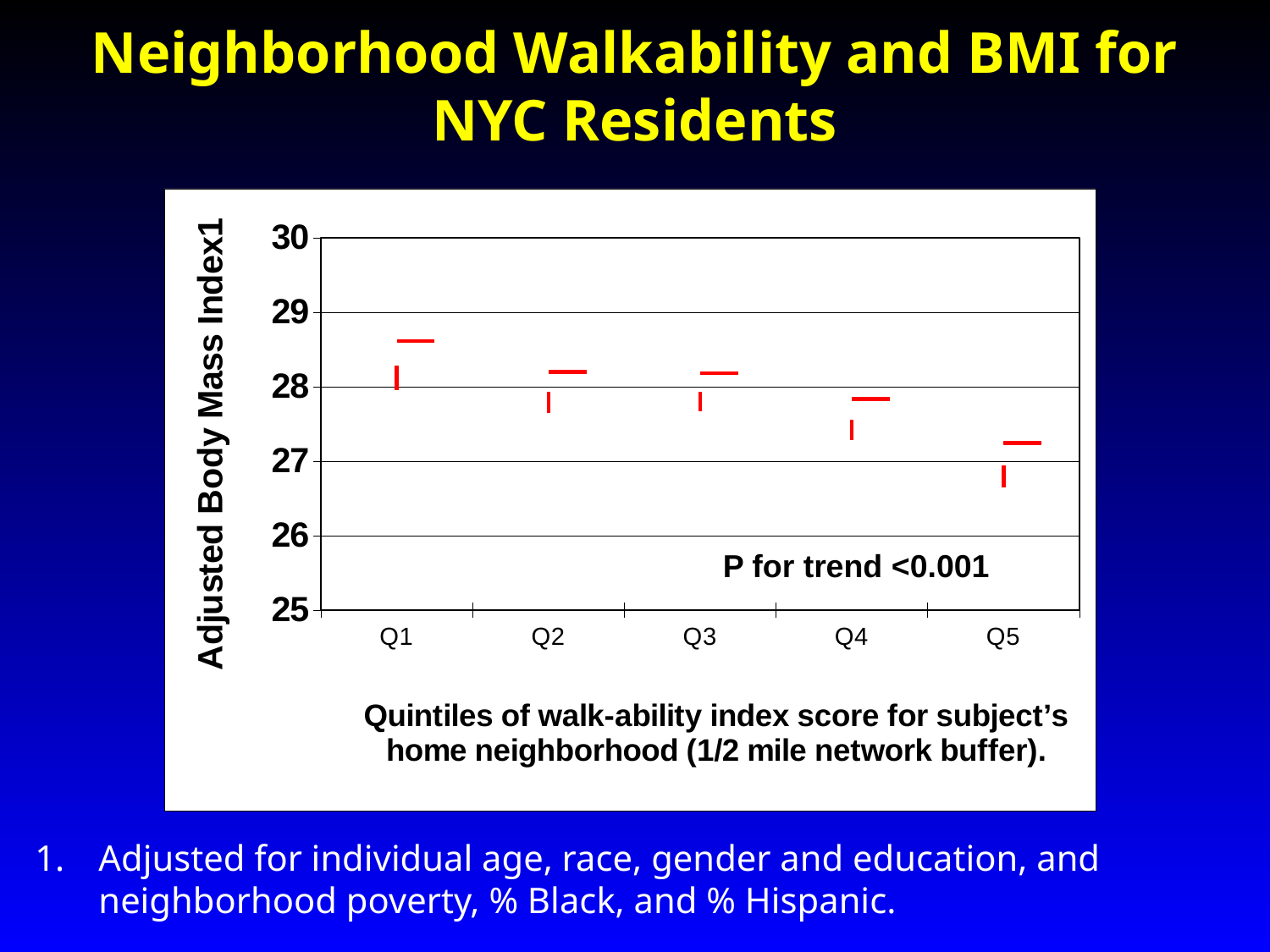
Which has a higher adjusted BMI, Q1 or Q5? Q1 Is the adjusted BMI value for Q4 greater or less than 28? less Is the adjusted BMI value for Q1 greater or less than 28? greater Which quintile has the lowest adjusted body mass index? Q5 Is the adjusted BMI value for Q5 greater or less than 28? less Do the adjusted BMI values rise or fall from Q1 to Q5? fall Which has a higher adjusted BMI, Q1 or Q4? Q1 Which quintile has the highest adjusted body mass index? Q1 What P value for trend is stated on the chart? P for trend <0.001 How many walkability quintiles are plotted on the x axis? 5